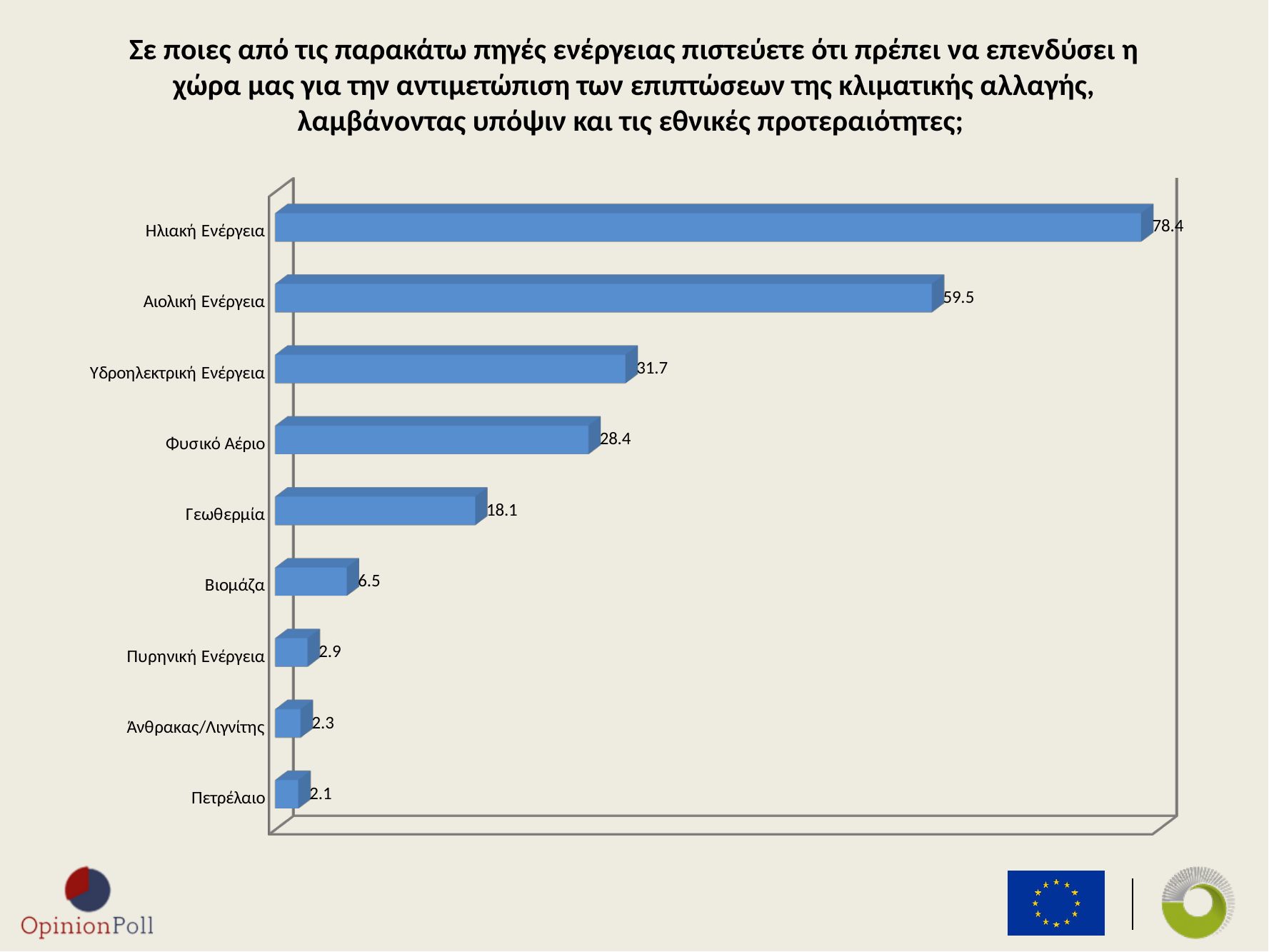
What is the difference between the values for Ηλιακή Ενέργεια and Αιολική Ενέργεια? 18.9 Which category has the highest value? Ηλιακή Ενέργεια What is the value for Γεωθερμία? 18.1 What is the value for Ηλιακή Ενέργεια? 78.4 What is the value for Άνθρακας/Λιγνίτης? 2.3 Which category has the lowest value? Πετρέλαιο How many categories are shown in the chart? 9 What kind of chart is shown on the slide? Bar chart Which is larger, the value for Υδροηλεκτρική Ενέργεια or the value for Φυσικό Αέριο? Υδροηλεκτρική Ενέργεια What is the value for Υδροηλεκτρική Ενέργεια? 31.7 What colour are the bars in the chart? Blue What is the difference between the values for Φυσικό Αέριο and Γεωθερμία? 10.3